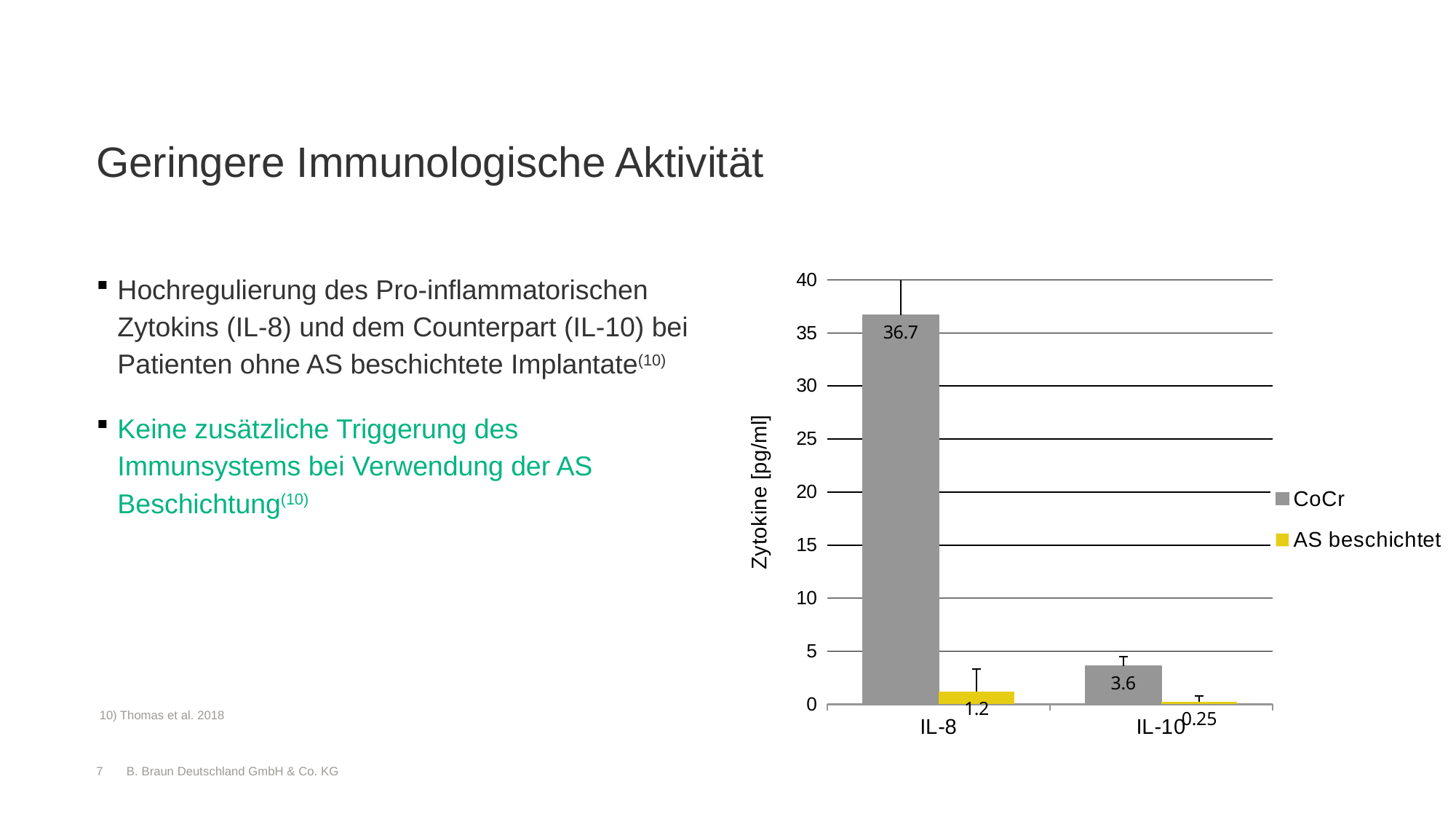
What is the AS beschichtet value for IL-8? 1.2 Which category has the highest CoCr value? IL-8 What is the AS beschichtet value for IL-10? 0.25 What is the CoCr value for IL-10? 3.6 Which category has the lowest AS beschichtet value? IL-10 What is the difference between the CoCr and AS beschichtet values for IL-10? 3.35 What is the difference between the CoCr and AS beschichtet values for IL-8? 35.5 What is the label of the y axis? Zytokine [pg/ml] Which is larger for IL-10, the CoCr value or the AS beschichtet value? CoCr What is the CoCr value for IL-8? 36.7 What kind of chart is shown on the slide? Bar chart How many series does the legend list? 2